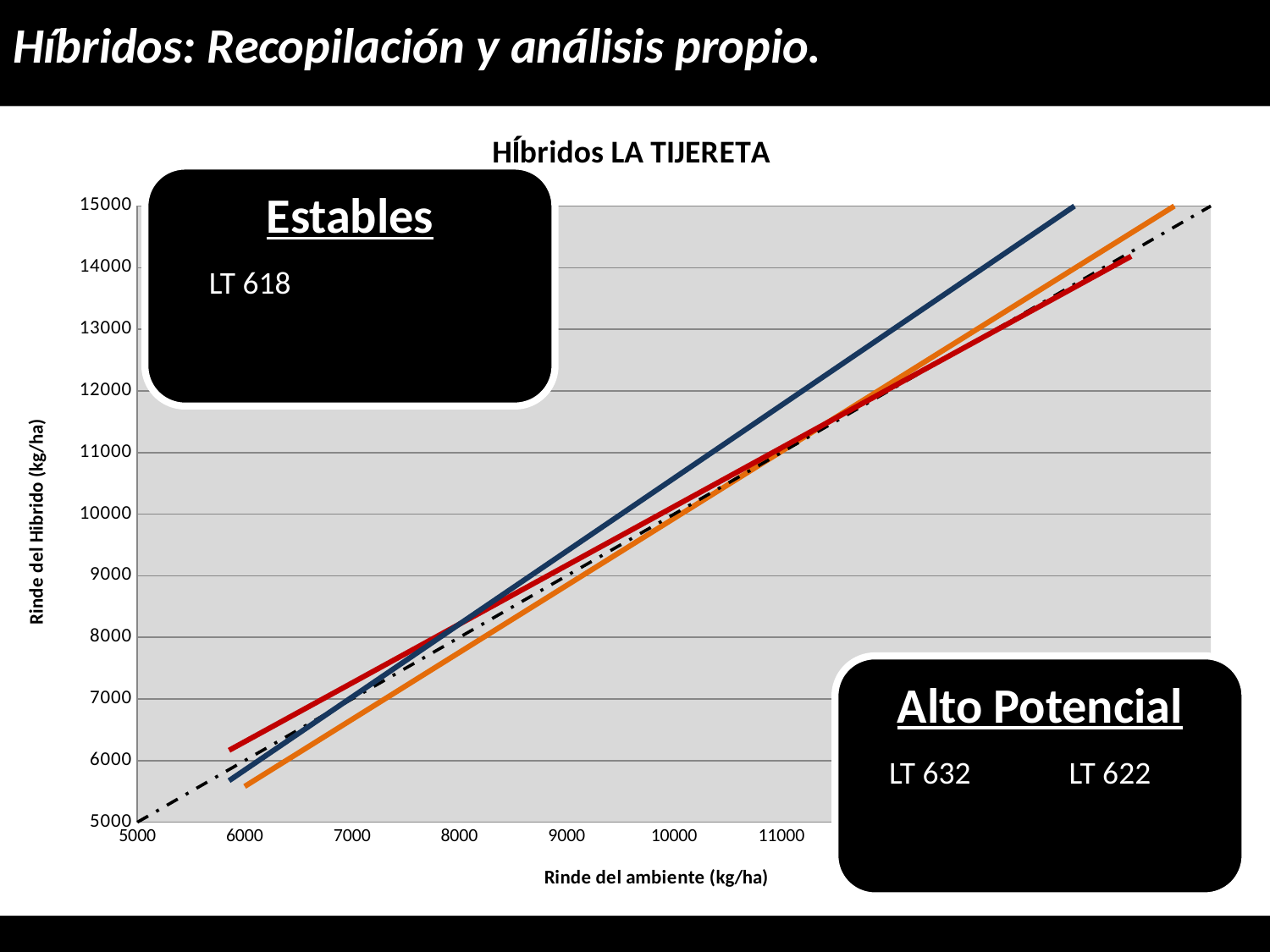
At an x value of 10000, is the blue line or the orange line higher? the blue line Do the plotted lines rise or fall as the x axis value (Rinde del ambiente) increases? rise Which coloured line has the lowest value at an x value of 6000? the orange line What is the title of the chart? HÍbridos LA TIJERETA Is the value of the orange line at an x value of 7000 greater or less than 8000? less Which coloured line has the highest value at an x value of 10000? the blue line How many solid coloured lines are plotted on the chart? 3 Is the value of the red line at an x value of 6000 greater or less than 7000? less What is the label of the y axis of the chart? Rinde del Hibrido (kg/ha) Which coloured line has the highest value at an x value of 6000? the red line What kind of chart is shown on the slide? line chart Is the value of the blue line at an x value of 10000 greater or less than 11000? greater